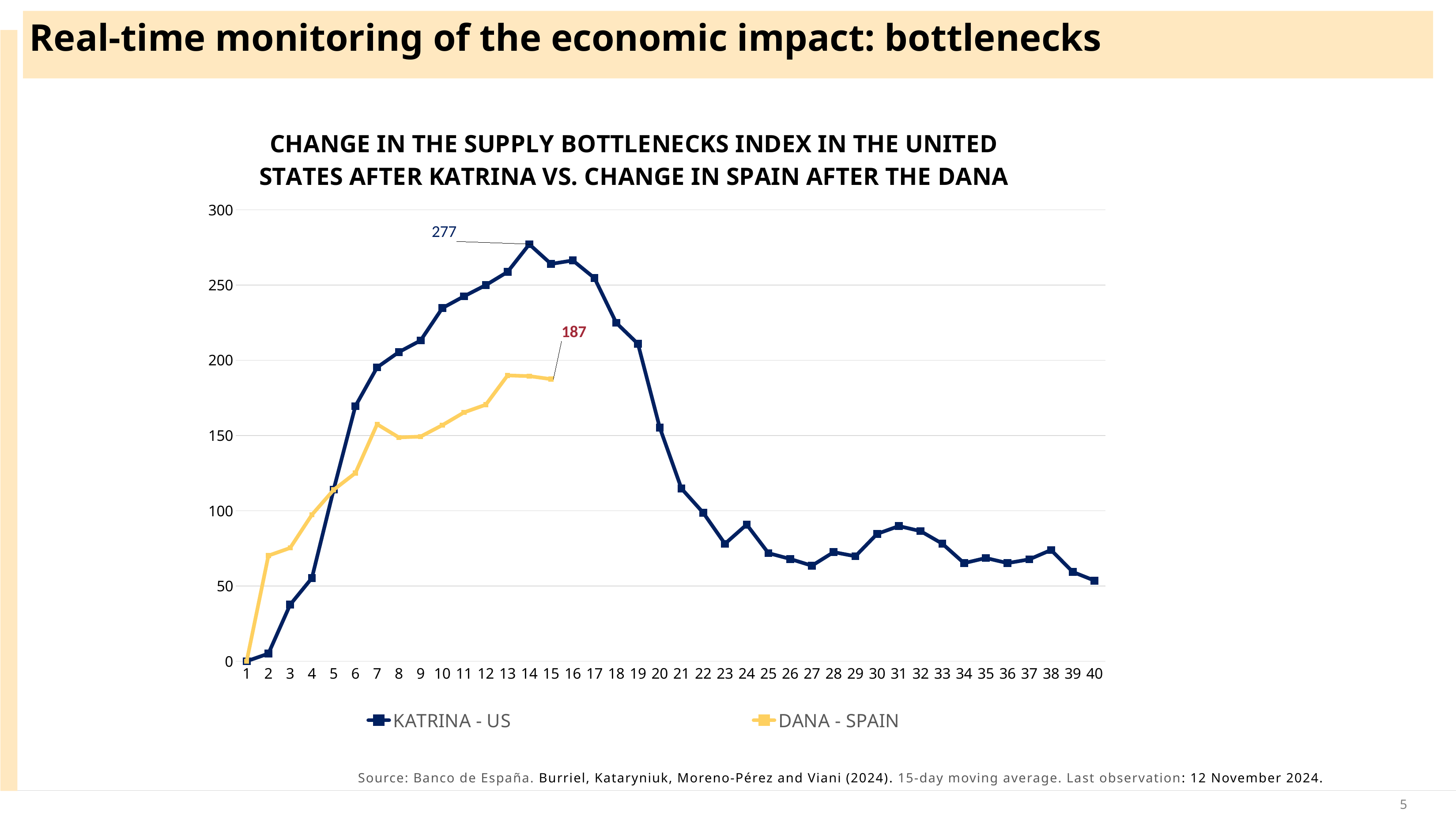
Does the KATRINA - US series rise or fall between x = 14 and x = 21? Fall How many series does the legend list? 2 What is the labelled peak value of the KATRINA - US series? 277 At x = 3, which series has the larger value, KATRINA - US or DANA - SPAIN? DANA - SPAIN At x = 10, which series has the larger value, KATRINA - US or DANA - SPAIN? KATRINA - US What is the labelled value at the last plotted point of the DANA - SPAIN series? 187 Is the value for KATRINA - US at x = 40 greater or less than 100? less Is the value for DANA - SPAIN at x = 2 greater or less than 50? greater How many points are plotted on the x axis (the highest x-axis label)? 40 What kind of chart is shown on the slide? Line chart What is the difference between the labelled peak of KATRINA - US (277) and the labelled last value of DANA - SPAIN (187)? 90 Which series reaches the higher peak value on the chart? KATRINA - US